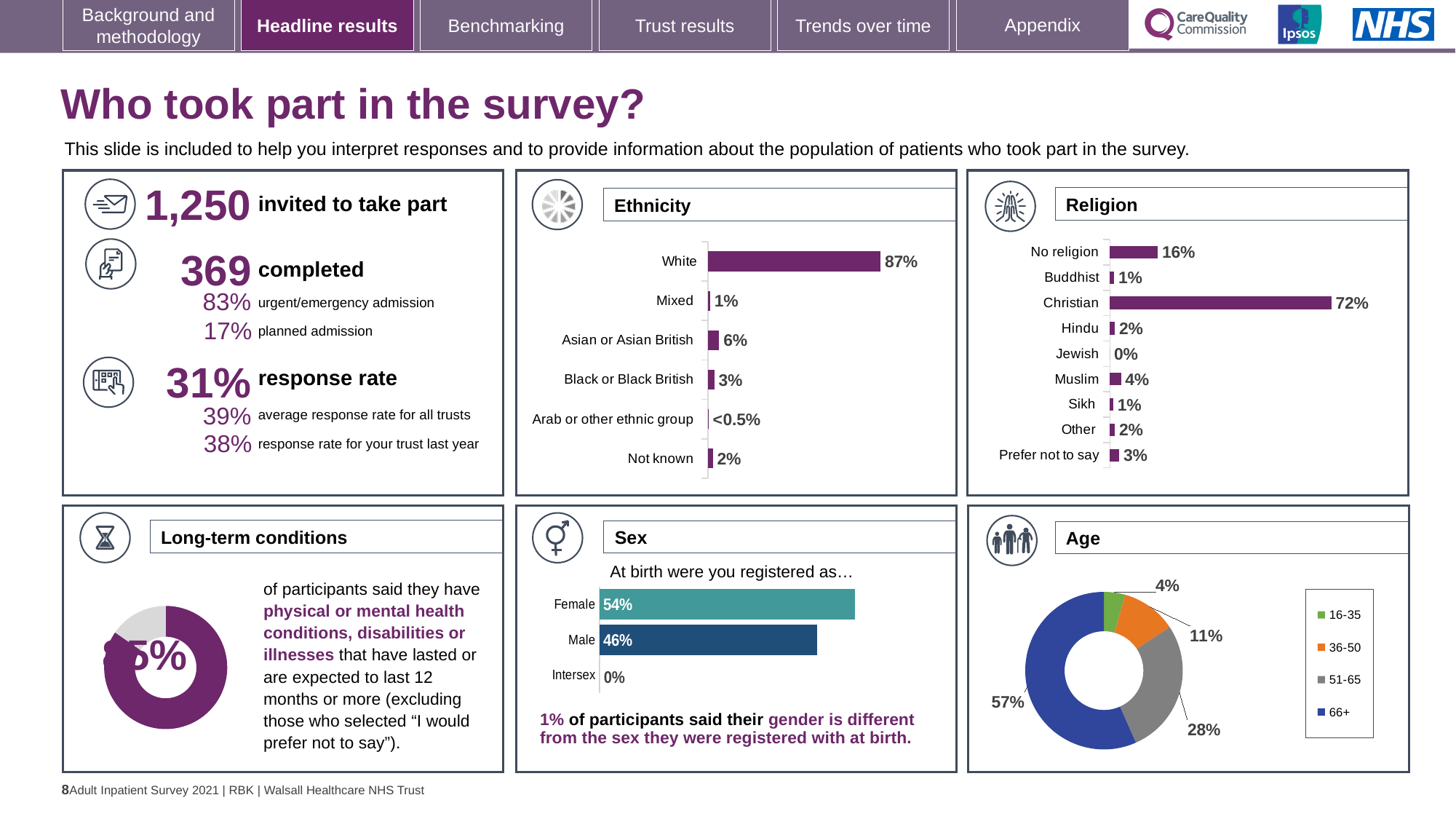
In the Sex chart, what is the difference between the Female and Male percentages? 8% What kind of chart is the Age chart? Doughnut chart In the Ethnicity chart, how many ethnicity categories are shown? 6 In the Religion chart, which is larger, the value for Muslim or the value for Hindu? Muslim In the Age chart, what share of participants were aged 66+? 57% In the Sex chart, what percentage of participants were registered as Female at birth? 54% In the Religion chart, which religion category has the lowest percentage? Jewish In the Ethnicity chart, what percentage of participants were Asian or Asian British? 6% In the Ethnicity chart, what percentage of participants were White? 87% In the Religion chart, what is the difference between the percentage for Christian and the percentage for No religion? 56% In the Ethnicity chart, which ethnic group has the highest percentage? White In the Religion chart, what percentage of participants were Christian? 72%